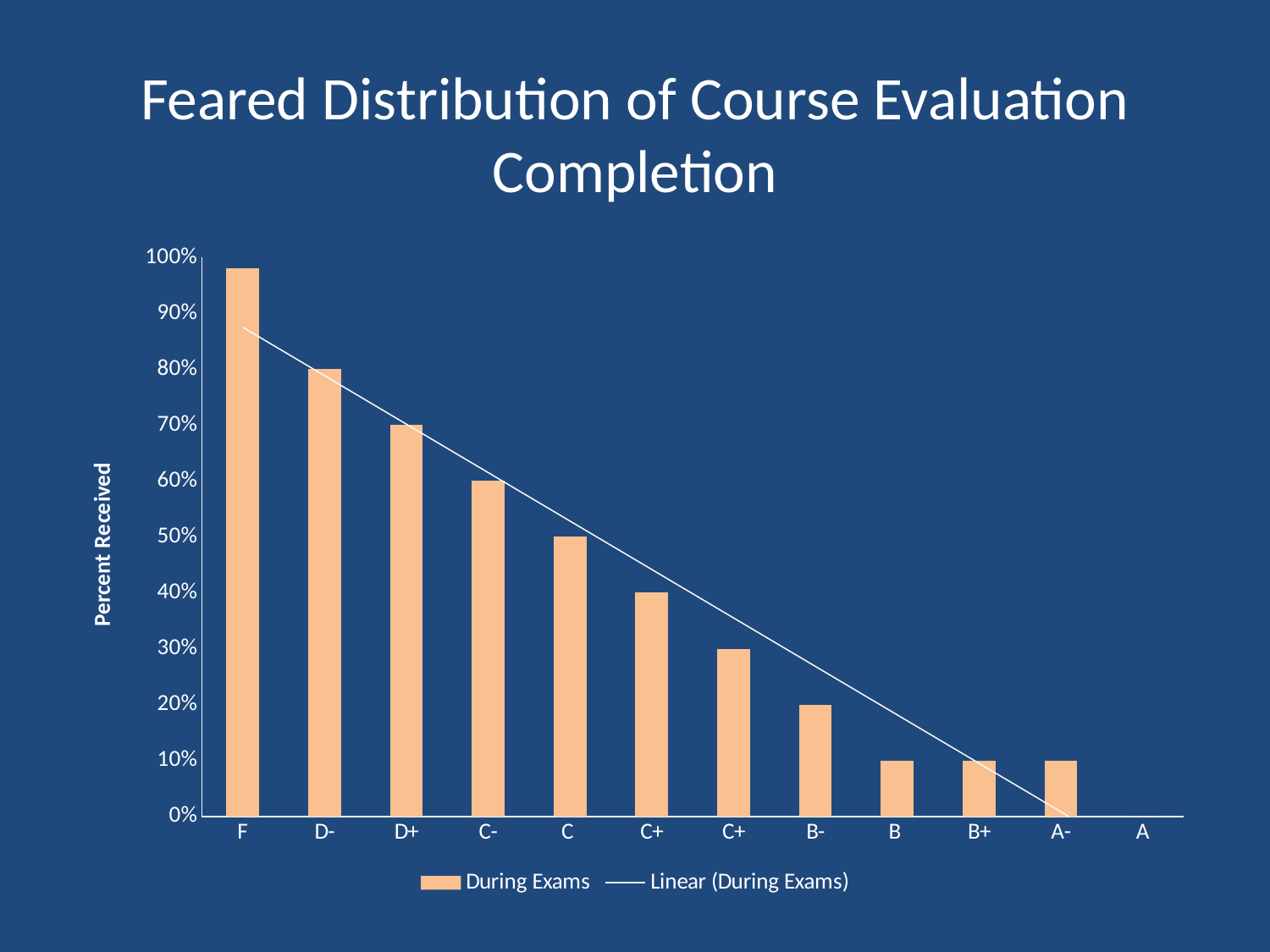
Is the value for F greater or less than 90%? greater Do the bar values rise or fall moving from F to A along the x axis? fall How many grade categories are shown on the x axis? 12 What is the difference between the percent received for D+ and for C-? 10% What is the title of the y axis? Percent Received How many series does the legend list? 2 What is the percent received for the B- category? 20% What is the percent received for the D- category? 80% Which is larger, the value for D+ or the value for B? D+ Which grade category has the highest percent received? F What kind of chart is shown on the slide? bar chart What is the percent received for the C category? 50%